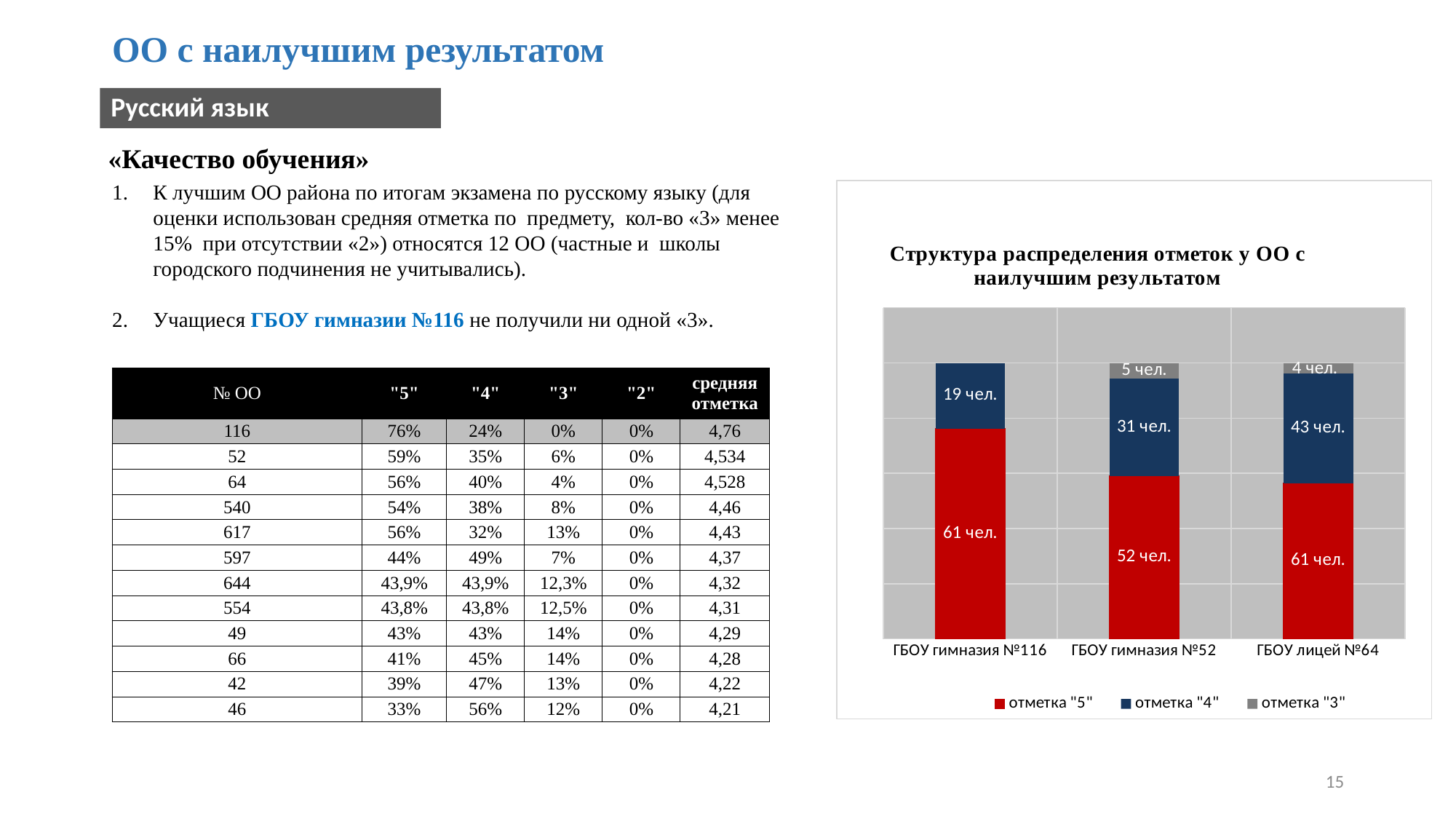
How many students received отметка "5" at ГБОУ гимназия №116 according to the chart? 61 чел. What is the difference between the number of students with отметка "4" at ГБОУ лицей №64 and at ГБОУ гимназия №116? 24 чел. What is the total number of students shown in the stacked bar for ГБОУ гимназия №52? 88 чел. Which school has the highest number of students with отметка "4" in the chart? ГБОУ лицей №64 Which school has the lowest number of students with отметка "5" in the chart? ГБОУ гимназия №52 What is the title of the chart on the slide? Структура распределения отметок у ОО с наилучшим результатом How many series does the chart legend list? 3 How many schools (categories) are shown on the x axis of the chart? 3 How many students received отметка "3" at ГБОУ лицей №64 according to the chart? 4 чел. What kind of chart is shown on the slide? stacked bar chart How many students received отметка "4" at ГБОУ гимназия №52 according to the chart? 31 чел. Which colour represents отметка "5" in the chart? red